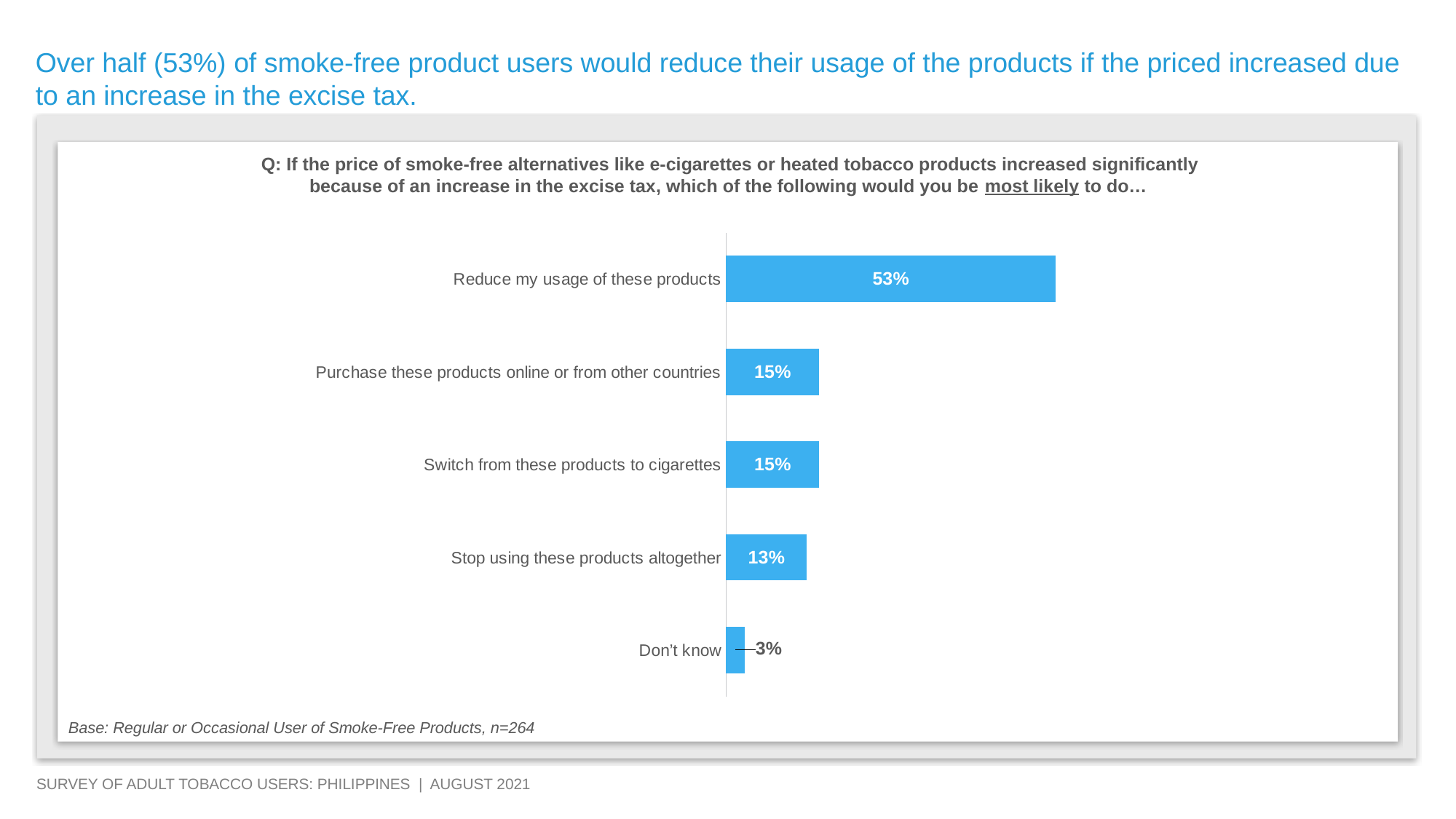
What is the difference in percentage points between 'Reduce my usage of these products' and 'Switch from these products to cigarettes'? 38 percentage points What percentage of respondents said they would reduce their usage of these products? 53% What type of chart is shown on the slide? Bar chart Which response has the lowest percentage? Don't know What percentage of respondents answered 'Don't know'? 3% What is the base sample size (n) stated below the chart? n=264 What percentage of respondents said they would stop using these products altogether? 13% Which is larger: the percentage for 'Switch from these products to cigarettes' or for 'Stop using these products altogether'? Switch from these products to cigarettes What percentage of respondents said they would purchase these products online or from other countries? 15% Which response has the highest percentage? Reduce my usage of these products How many response categories are shown in the chart? 5 What is the difference in percentage points between 'Stop using these products altogether' and 'Don't know'? 10 percentage points